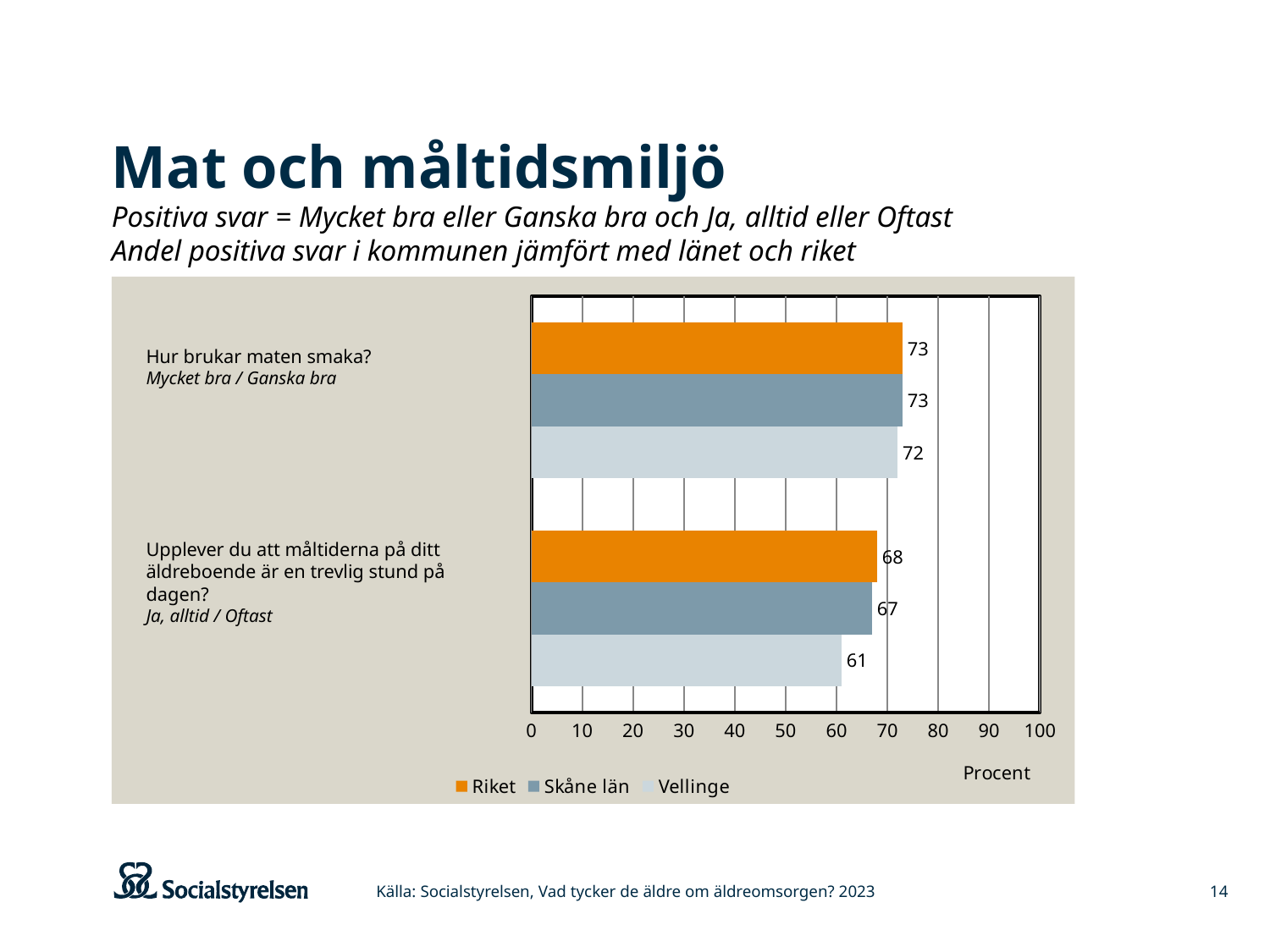
Which is larger for Vellinge: the value for "Hur brukar maten smaka?" or the value for "Upplever du att måltiderna på ditt äldreboende är en trevlig stund på dagen?"? Hur brukar maten smaka? What is the value for Vellinge for "Hur brukar maten smaka?"? 72 How many series does the legend list? 3 What kind of chart is shown on the slide? Bar chart Is the value for Vellinge for "Upplever du att måltiderna på ditt äldreboende är en trevlig stund på dagen?" greater or less than 70? less What is the value for Riket for "Hur brukar maten smaka?"? 73 What is the value for Vellinge for "Upplever du att måltiderna på ditt äldreboende är en trevlig stund på dagen?"? 61 What is the difference between the Riket and Vellinge values for "Upplever du att måltiderna på ditt äldreboende är en trevlig stund på dagen?"? 7 What is the value for Skåne län for "Upplever du att måltiderna på ditt äldreboende är en trevlig stund på dagen?"? 67 Which series has the lowest value for "Upplever du att måltiderna på ditt äldreboende är en trevlig stund på dagen?"? Vellinge What unit is shown on the x axis of the chart? Procent What is the value for Riket for "Upplever du att måltiderna på ditt äldreboende är en trevlig stund på dagen?"? 68